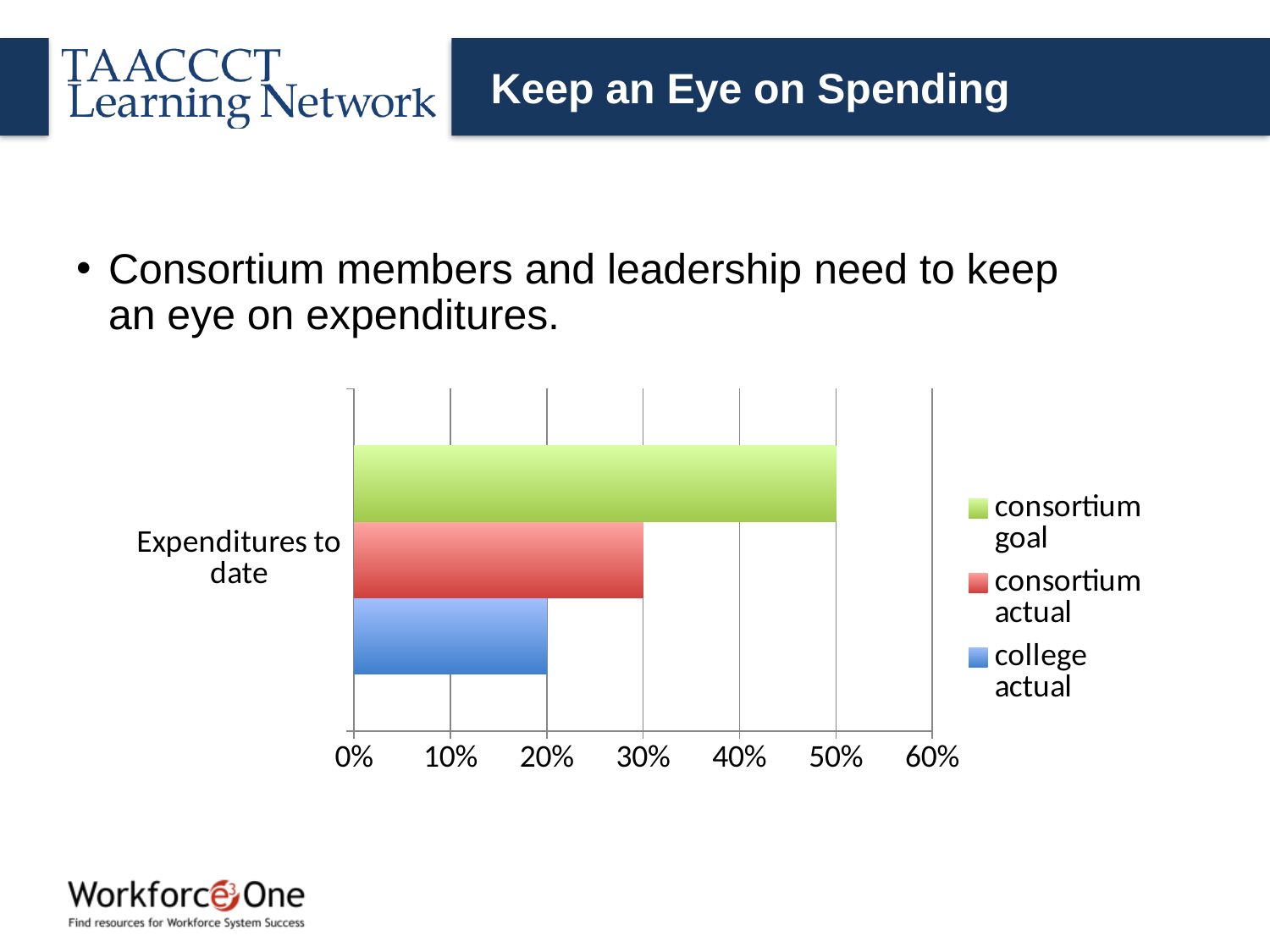
What is the value of the college actual bar for Expenditures to date? 20% How many categories are shown on the vertical axis of the chart? 1 What is the value of the consortium actual bar for Expenditures to date? 30% What kind of chart is shown on the slide? bar chart What colour is the consortium goal series in the chart? green Which is larger, the consortium actual value or the college actual value? consortium actual What is the value of the consortium goal bar for Expenditures to date? 50% Is the value for consortium actual greater or less than 40%? less How many series does the chart legend list? 3 What is the difference between the consortium goal and the consortium actual values? 20% Which series has the highest value for Expenditures to date? consortium goal Which series has the lowest value for Expenditures to date? college actual